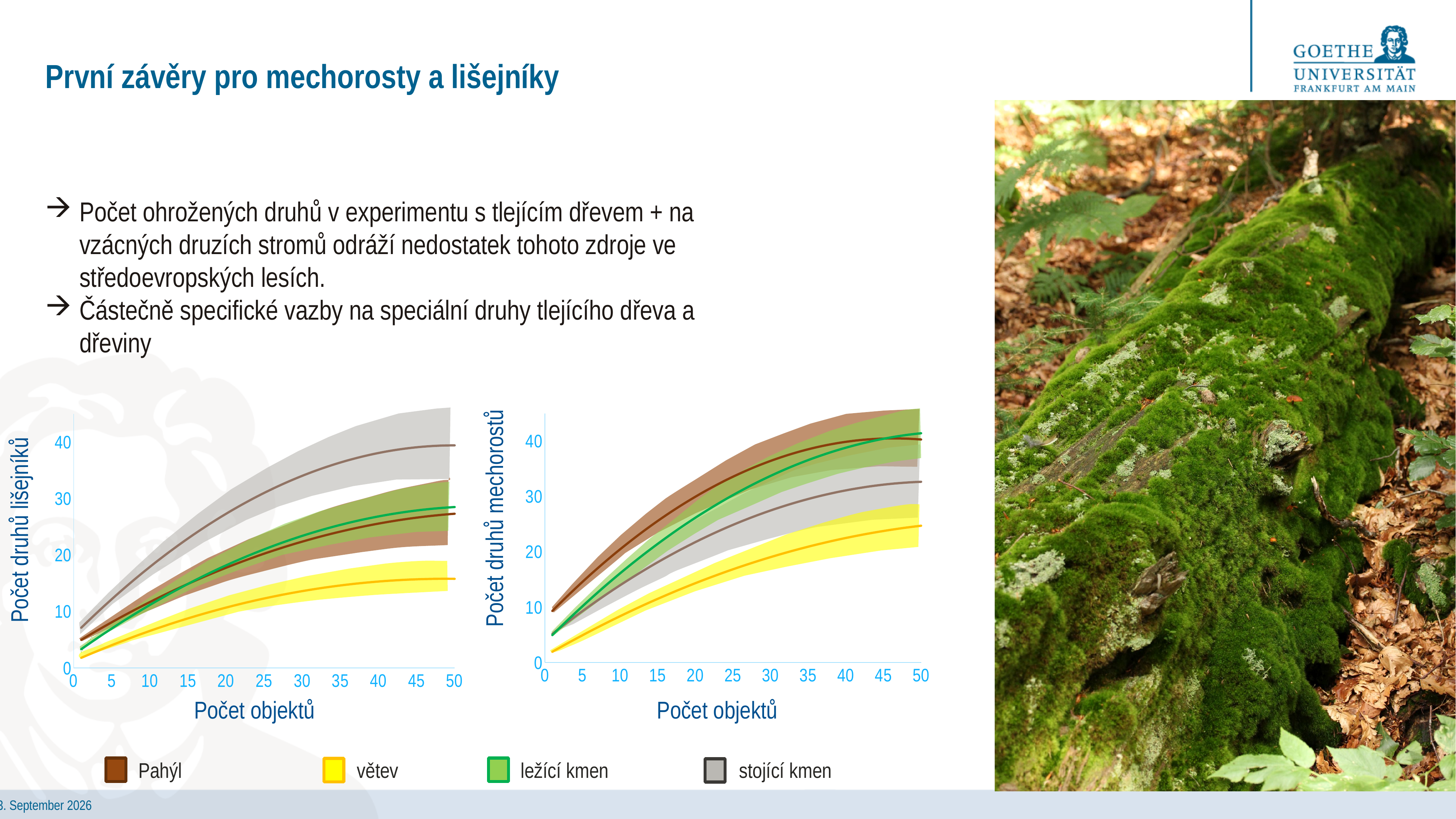
In the left chart (Počet druhů lišejníků), is the value for větev at 50 objects greater or less than 20? less In the left chart (Počet druhů lišejníků), which series has the highest value at 50 objects? stojící kmen How many series does the legend list for the charts? 4 In the left chart (Počet druhů lišejníků), which series has the lowest value at 50 objects? větev In the right chart (Počet druhů mechorostů), which series has the lowest value at 50 objects? větev In the left chart (Počet druhů lišejníků), is the value for stojící kmen at 50 objects greater or less than 30? greater What kind of chart is the left chart (Počet druhů lišejníků)? line chart In the left chart (Počet druhů lišejníků), do the values for stojící kmen rise or fall as the number of objects increases? rise What is the x-axis label of the right chart? Počet objektů In the right chart (Počet druhů mechorostů), is the value for ležící kmen at 50 objects greater or less than 30? greater In the right chart (Počet druhů mechorostů), which is larger at 50 objects: stojící kmen or větev? stojící kmen